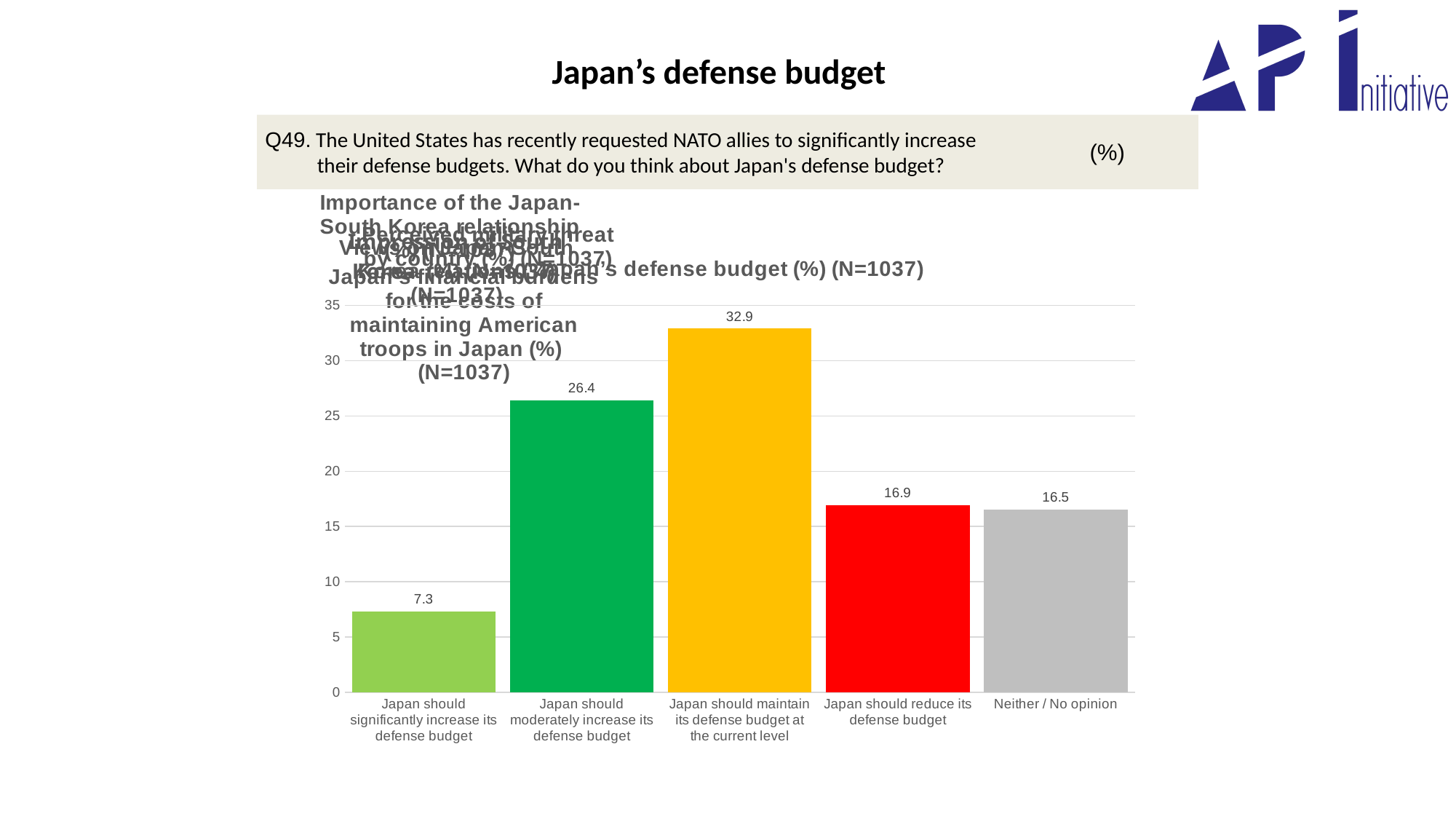
Which response category has the highest value? Japan should maintain its defense budget at the current level Is the value for "Japan should significantly increase its defense budget" greater or less than 10? less Which is larger: the value for "Japan should moderately increase its defense budget" or the value for "Japan should reduce its defense budget"? Japan should moderately increase its defense budget What percentage of respondents said Japan should significantly increase its defense budget? 7.3 What is the value for "Japan should maintain its defense budget at the current level"? 32.9 What is the value for "Japan should reduce its defense budget"? 16.9 What is the value for "Neither / No opinion"? 16.5 How many response categories are shown in the chart? 5 Which response category has the lowest value? Japan should significantly increase its defense budget What type of chart is shown on the slide? bar chart What is the difference between the values for "Japan should maintain its defense budget at the current level" and "Japan should moderately increase its defense budget"? 6.5 What is the value for "Japan should moderately increase its defense budget"? 26.4